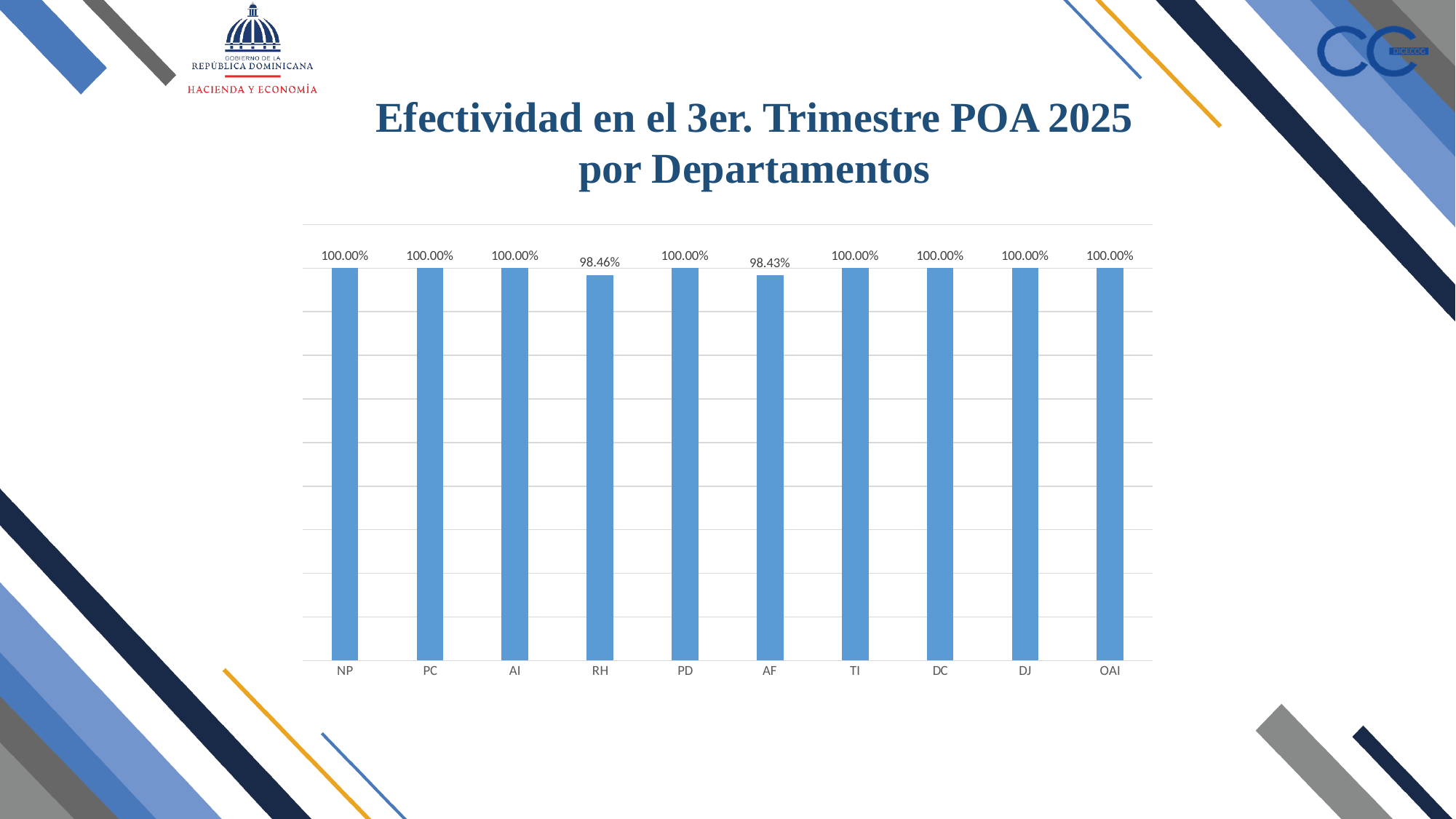
What is the difference between the values for NP and RH? 1.54% What is the value for NP? 100.00% What is the difference between the values for RH and AF? 0.03% What is the title of the chart on the slide? Efectividad en el 3er. Trimestre POA 2025 por Departamentos What is the value for RH? 98.46% What is the value for OAI? 100.00% Which is larger, the value for RH or the value for AF? RH Which department has the lowest value? AF How many departments are shown on the chart? 10 What is the value for AF? 98.43% Which is larger, the value for PD or the value for AF? PD What kind of chart is shown on the slide? Bar chart